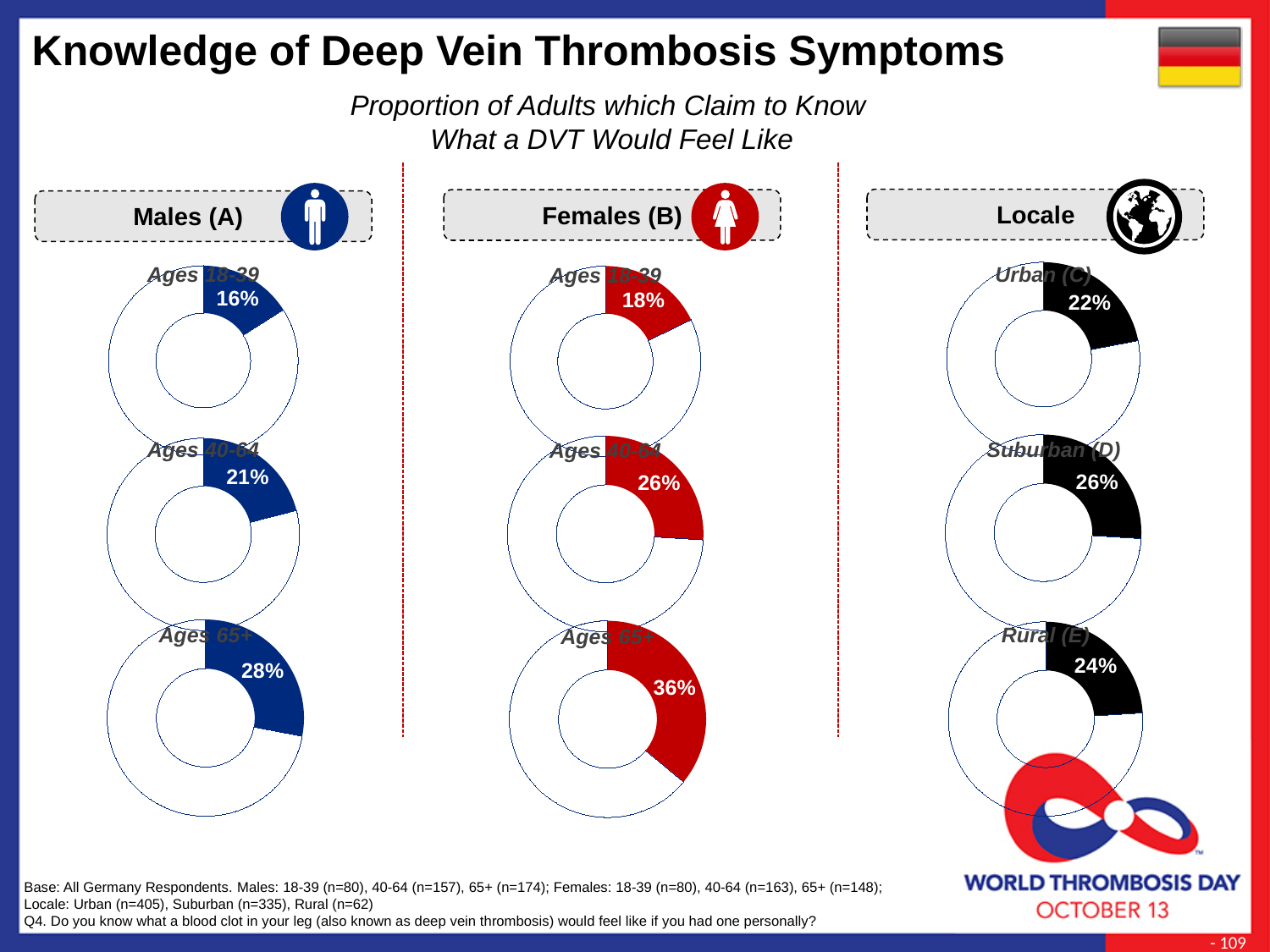
In the Males (A) column, what percentage of adults aged 18-39 claim to know what a DVT would feel like? 16% In the Males (A) column, what is the value shown for Ages 40-64? 21% In the Females (B) column, what is the value shown for Ages 65+? 36% How many donut charts are shown in the Locale column? 3 What is the difference between the Females (B) Ages 65+ value and the Males (A) Ages 65+ value? 8% What kind of chart is used to show the Females (B) Ages 40-64 value? donut (pie) chart In the Locale column, what is the value shown for Suburban (D)? 26% In the Females (B) column, which age group has the lowest value? Ages 18-39 In the Locale column, which locale has the highest value? Suburban (D) What colour are the filled segments in the Females (B) column charts? red In the Males (A) column, do the values rise or fall as the age group gets older? rise Which is larger: the Locale Urban (C) value or the Locale Rural (E) value? Rural (E)